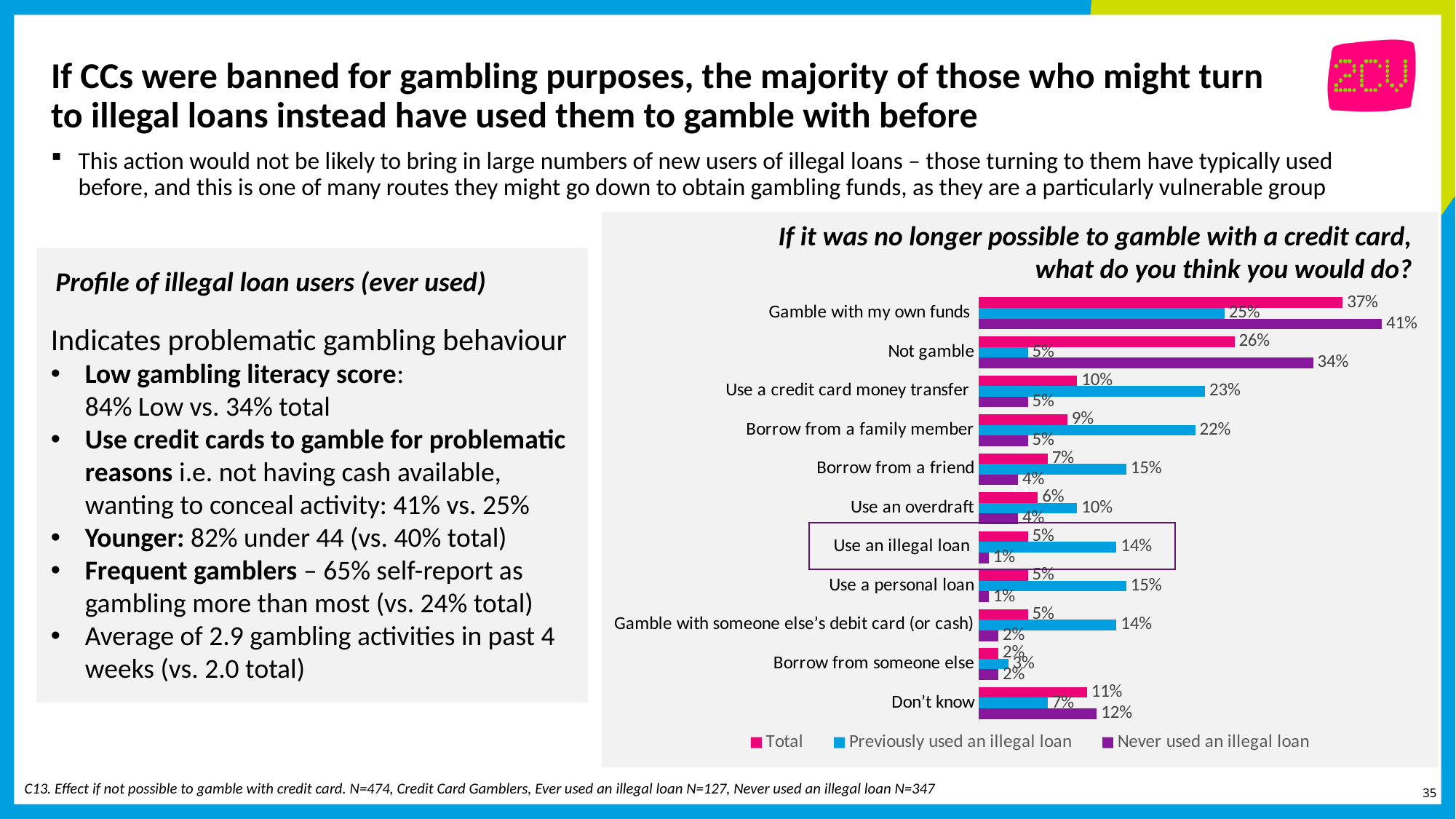
What is the Total value for 'Don't know'? 11% What is the difference between the Total values for 'Gamble with my own funds' and 'Not gamble'? 11% Which category has the highest Total value? Gamble with my own funds What is the value for 'Never used an illegal loan' for 'Gamble with my own funds'? 41% What is the value for 'Previously used an illegal loan' for 'Use an illegal loan'? 14% Which category is highlighted with a box in the chart? Use an illegal loan What is the difference between the 'Previously used an illegal loan' and 'Never used an illegal loan' values for 'Use a credit card money transfer'? 18% What type of chart is shown on the slide? bar chart How many response categories are shown in the chart? 11 What is the Total value for 'Use an illegal loan'? 5% For 'Not gamble', which is larger: the 'Previously used an illegal loan' value or the 'Never used an illegal loan' value? Never used an illegal loan How many series does the chart legend list? 3